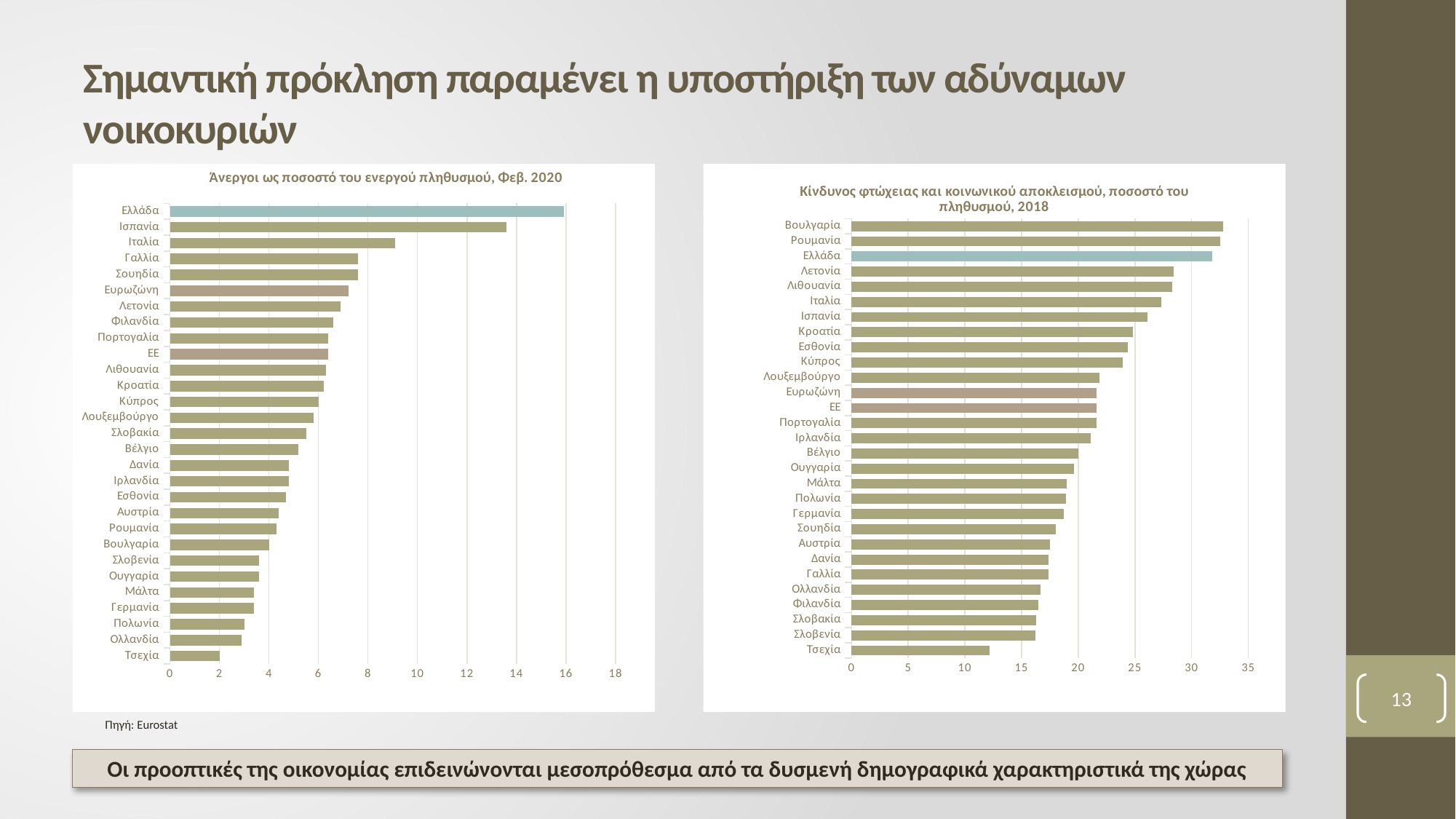
In the left chart (unemployment, Feb. 2020), which country has the lowest value? Τσεχία What is the title of the right chart? Κίνδυνος φτώχειας και κοινωνικού αποκλεισμού, ποσοστό του πληθυσμού, 2018 How many categories (bars) are shown in the left chart (unemployment, Feb. 2020)? 29 In the left chart (unemployment, Feb. 2020), is the value for Ιταλία greater or less than 8? greater In the left chart (unemployment, Feb. 2020), is the value for Ισπανία greater or less than 12? greater In the right chart (risk of poverty and social exclusion, 2018), is the value for Τσεχία greater or less than 15? less In the left chart (unemployment, Feb. 2020), which country has the highest value? Ελλάδα What kind of chart is the left chart, 'Άνεργοι ως ποσοστό του ενεργού πληθυσμού, Φεβ. 2020'? bar chart In the left chart (unemployment, Feb. 2020), which has the larger value, Ισπανία or Ιταλία? Ισπανία In the right chart (risk of poverty and social exclusion, 2018), which country has the lowest value? Τσεχία In the right chart (risk of poverty and social exclusion, 2018), which has the larger value, Ελλάδα or Ισπανία? Ελλάδα